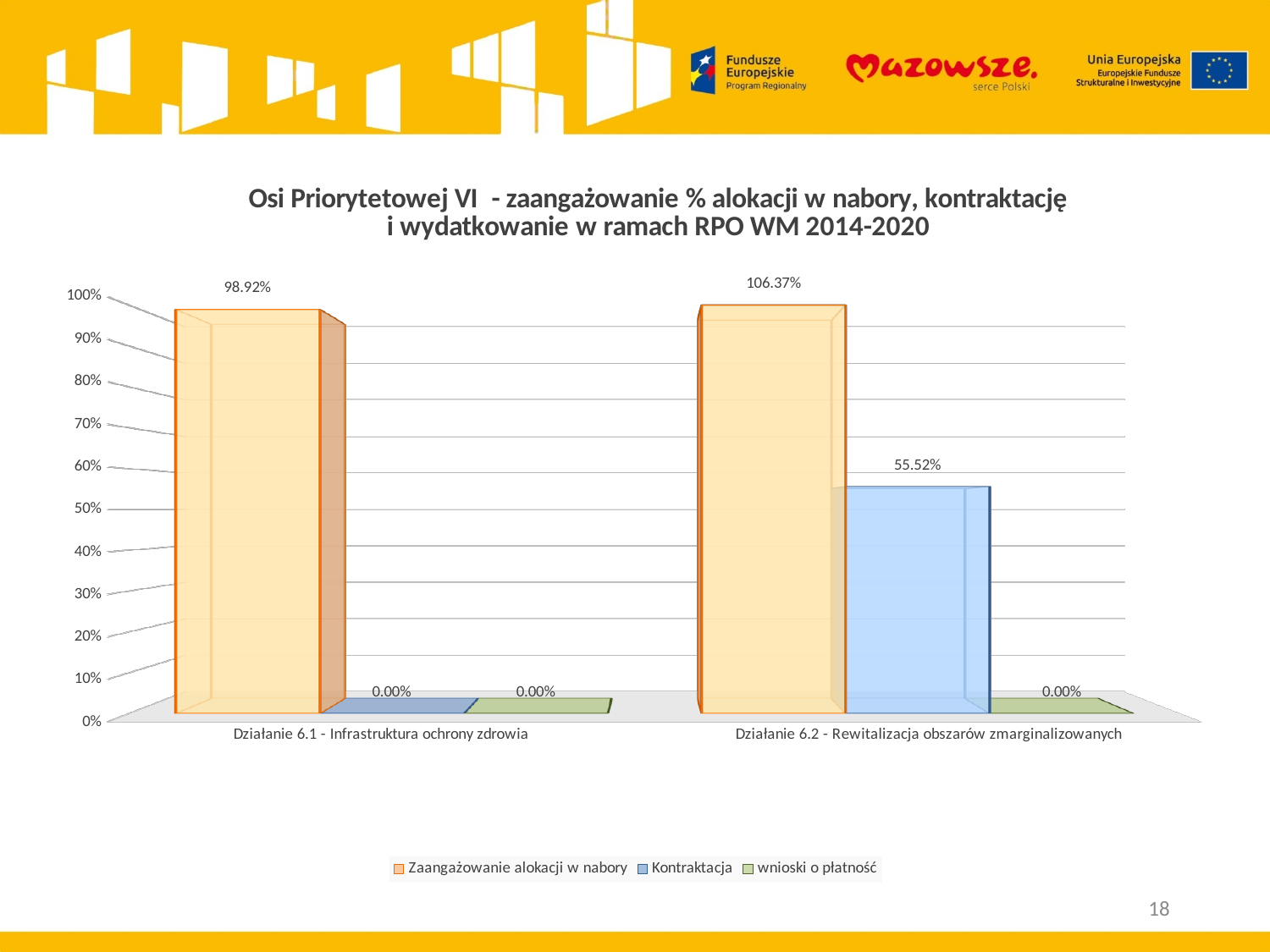
What is the Kontraktacja value for Działanie 6.2 - Rewitalizacja obszarów zmarginalizowanych? 55.52% What is the value of Zaangażowanie alokacji w nabory for Działanie 6.2 - Rewitalizacja obszarów zmarginalizowanych? 106.37% Which category has the higher Zaangażowanie alokacji w nabory value? Działanie 6.2 - Rewitalizacja obszarów zmarginalizowanych What type of chart is shown on the slide? Bar chart How many categories are shown on the x axis? 2 What is the difference between the Zaangażowanie alokacji w nabory values for Działanie 6.2 and Działanie 6.1? 7.45% Is the Kontraktacja value for Działanie 6.2 greater or less than 50%? greater For Działanie 6.2, what is the difference between Zaangażowanie alokacji w nabory and Kontraktacja? 50.85% What is the wnioski o płatność value for Działanie 6.2 - Rewitalizacja obszarów zmarginalizowanych? 0.00% How many series does the legend list? 3 What is the value of Zaangażowanie alokacji w nabory for Działanie 6.1 - Infrastruktura ochrony zdrowia? 98.92% What is the Kontraktacja value for Działanie 6.1 - Infrastruktura ochrony zdrowia? 0.00%